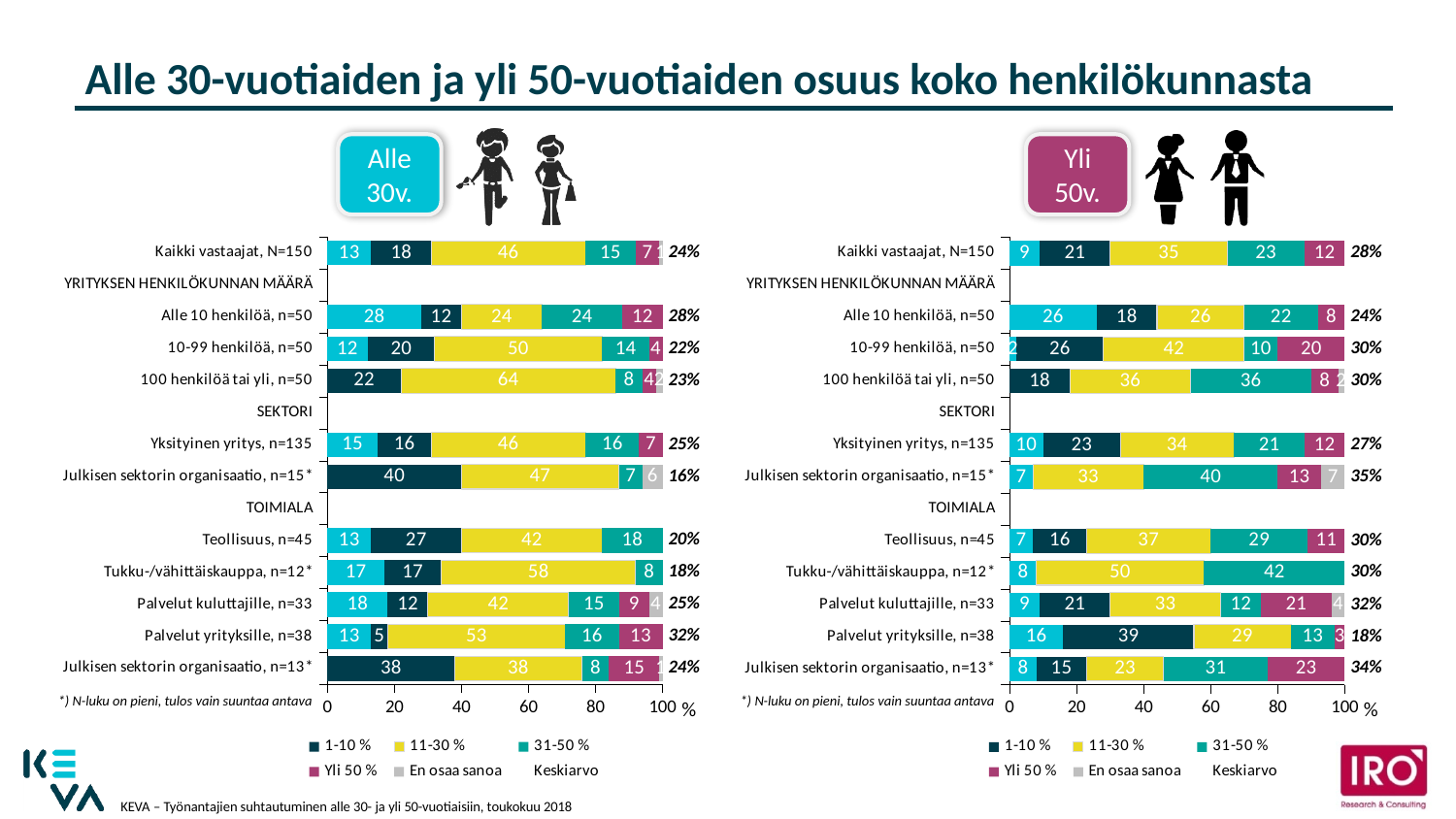
In the left chart (Alle 30v.), what is the value of the 11-30 % segment for Kaikki vastaajat, N=150? 46 In the left chart (Alle 30v.), what is the value of the 11-30 % segment for 100 henkilöä tai yli, n=50? 64 What type of chart is used on this slide? Stacked bar chart In the left chart (Alle 30v.), which category has the highest Keskiarvo? Palvelut yrityksille, n=38 (32%) In the left chart (Alle 30v.), how much larger is the 11-30 % segment for 100 henkilöä tai yli, n=50 than for 10-99 henkilöä, n=50? 14 How many entries does the legend of the left chart (Alle 30v.) list? 6 How many categories with bars are plotted in the right chart (Yli 50v.)? 11 In the left chart (Alle 30v.), which has the larger 1-10 % segment: Alle 10 henkilöä, n=50 or 10-99 henkilöä, n=50? 10-99 henkilöä, n=50 In the right chart (Yli 50v.), what is the value of the 31-50 % segment for Tukku-/vähittäiskauppa, n=12*? 42 In the right chart (Yli 50v.), what is the Keskiarvo shown for Kaikki vastaajat, N=150? 28% What is the title of the slide? Alle 30-vuotiaiden ja yli 50-vuotiaiden osuus koko henkilökunnasta In the right chart (Yli 50v.), which category has the lowest Keskiarvo? Palvelut yrityksille, n=38 (18%)